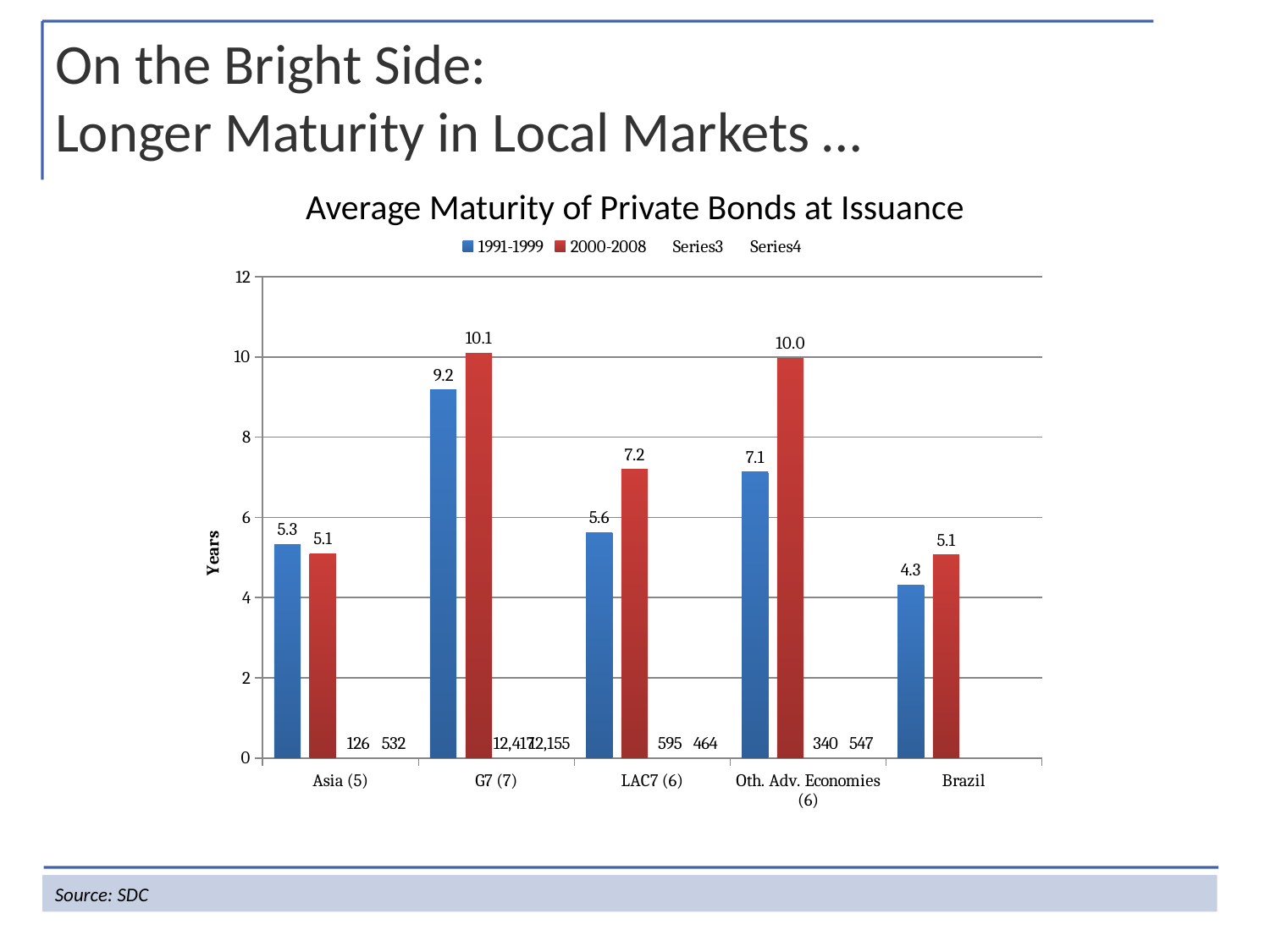
What is the value for LAC7 (6) in the 2000-2008 series? 7.2 Which category has the lowest value in the 1991-1999 series? Brazil What is the value for G7 (7) in the 2000-2008 series? 10.1 What kind of chart is shown on the slide? Bar chart Which category has the highest value in the 1991-1999 series? G7 (7) Which is larger for Asia (5): the 1991-1999 value or the 2000-2008 value? 1991-1999 Is the 2000-2008 value for Oth. Adv. Economies (6) greater or less than 8? greater What is the difference between the 2000-2008 and 1991-1999 values for Oth. Adv. Economies (6)? 2.9 What is the difference between the 2000-2008 and 1991-1999 values for LAC7 (6)? 1.6 What is the value for Brazil in the 1991-1999 series? 4.3 How many categories are shown on the x axis? 5 How many series does the legend list? 4